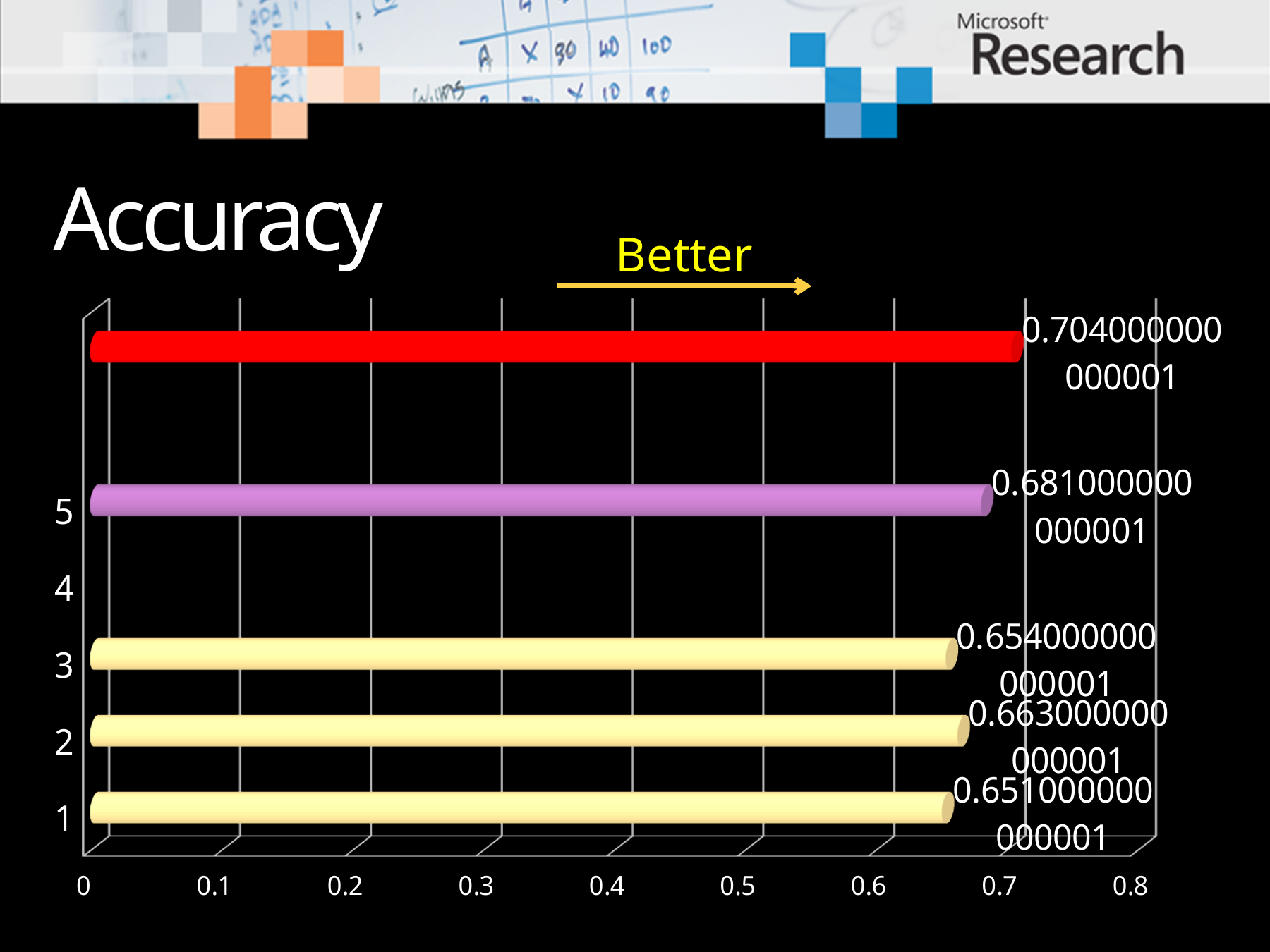
What is the value printed for category 1? 0.651000000000001 Is the value for category 1 greater or less than 0.6? greater What value is printed on the red bar at the top of the chart? 0.704000000000001 Which category has the lowest value? 1 What is the value printed for category 5? 0.681000000000001 Which is larger, the value for category 5 or the value for category 1? category 5 How many bars are plotted in the chart? 5 What is the difference between the values for category 5 and category 1? 0.03 What kind of chart is shown on the slide? bar chart What is the value printed for category 2? 0.663000000000001 Is the value for category 5 greater or less than 0.7? less What is the value printed for category 3? 0.654000000000001